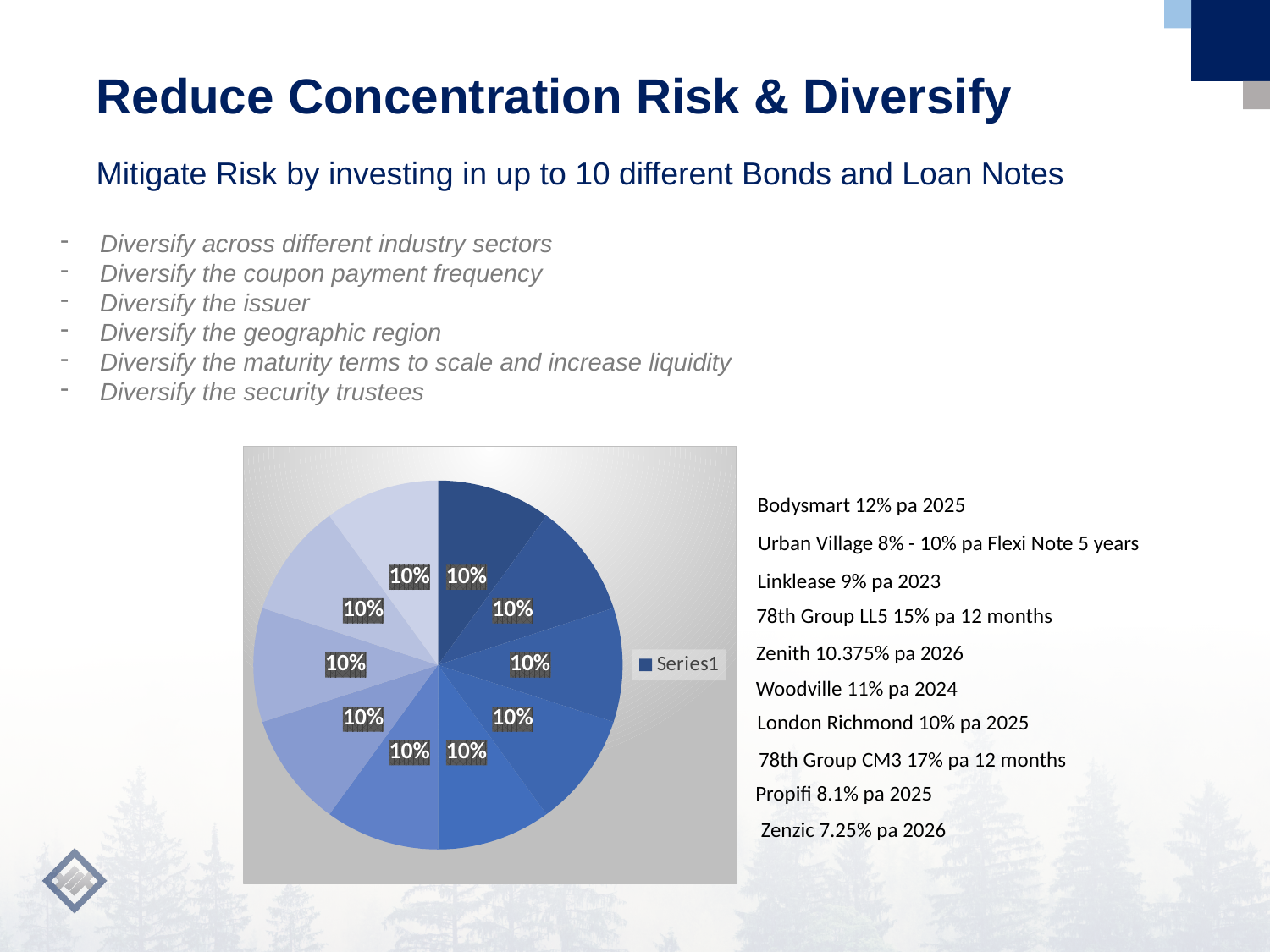
What share of the pie does each slice represent? 10% How many slices does the pie chart have? 10 What kind of chart is shown on the slide? pie chart Are all the slices of the pie chart the same size? yes What is the combined share of two slices of the pie chart? 20% Is the share of any single slice greater or less than 50%? less How many series does the chart legend list? 1 What is the name of the series shown in the chart legend? Series1 What percentage is printed on the largest slice of the pie chart? 10% What is the difference in share between any two slices of the pie chart? 0%